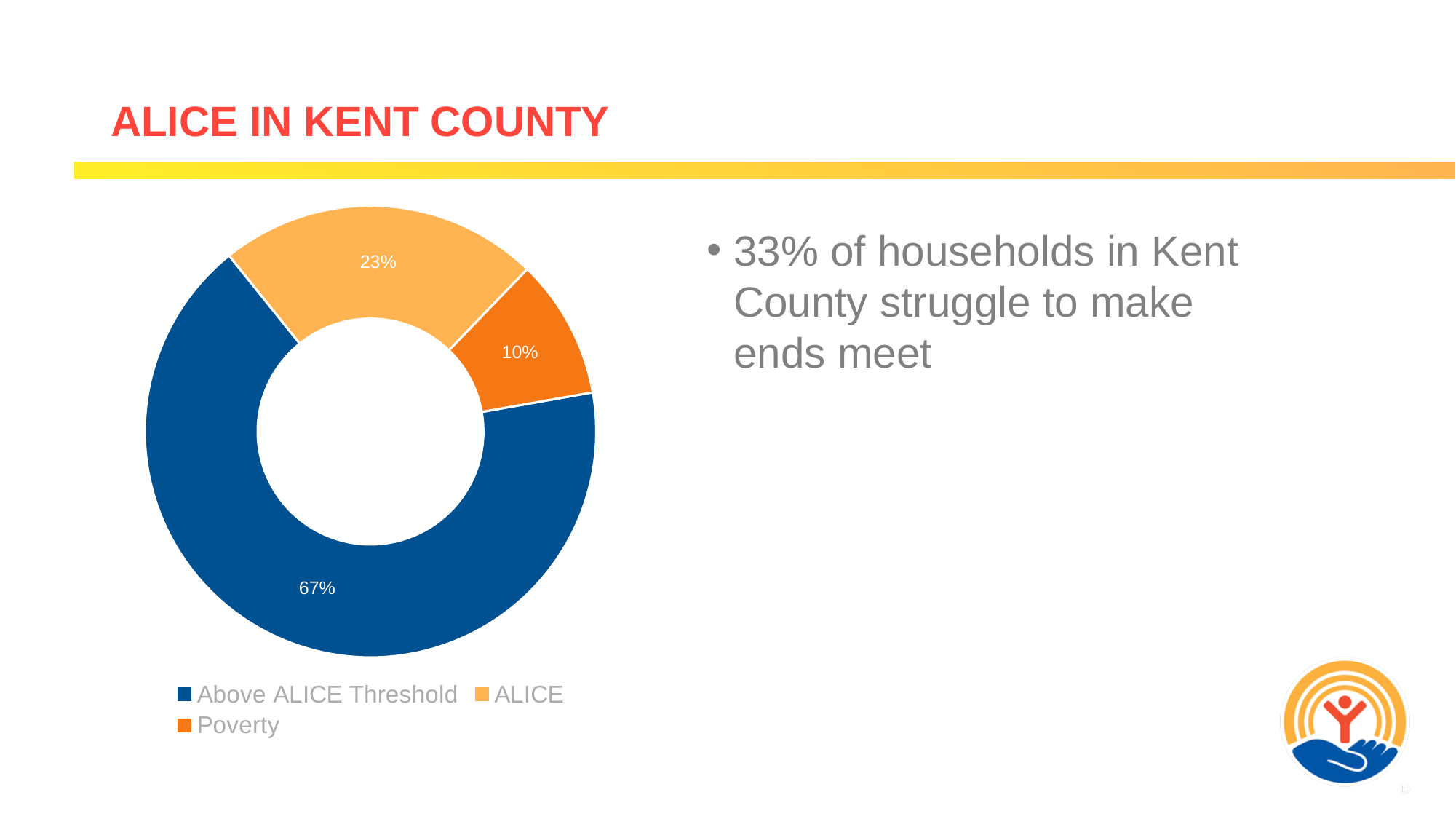
What is the difference between the ALICE share and the Poverty share? 13% What is the difference between the Above ALICE Threshold share and the ALICE share? 44% What kind of chart is shown on the slide? Doughnut (pie) chart Which is larger, the ALICE share or the Poverty share? ALICE Which category has the smallest share of the chart? Poverty What colour is the Poverty slice in the chart? Dark orange Which category has the largest share of the chart? Above ALICE Threshold What percentage of households are Above ALICE Threshold? 67% How many categories does the chart show? 3 What percentage of households are ALICE? 23% What percentage of households are in Poverty? 10% What is the combined share of the ALICE and Poverty categories? 33%